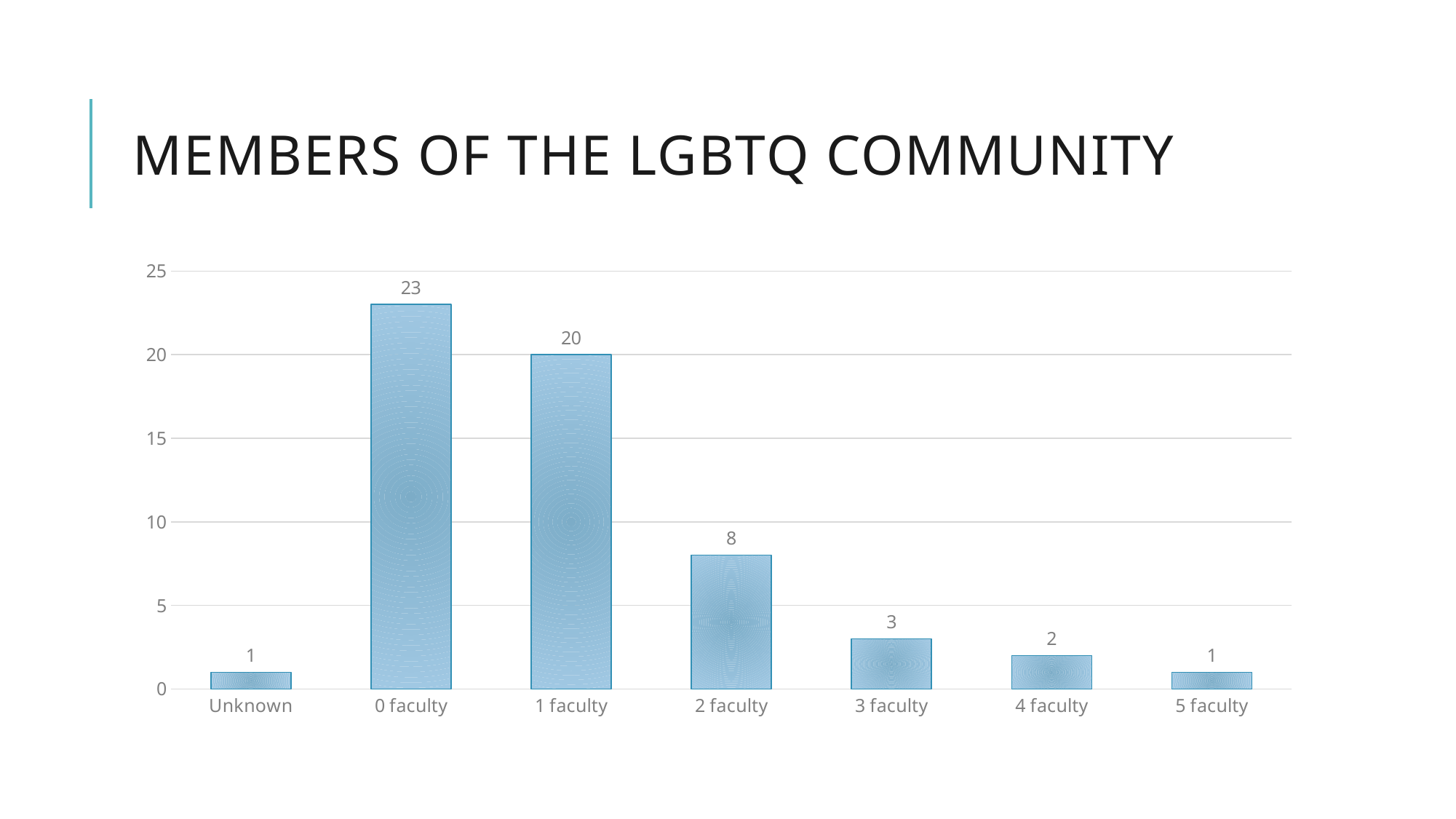
What is the value for Unknown? 1 What kind of chart is shown on the slide? bar chart Do the values rise or fall from 0 faculty to 5 faculty? fall How many categories are shown on the x axis? 7 What is the difference between the values for 0 faculty and 1 faculty? 3 What is the value for 2 faculty? 8 What is the value for 0 faculty? 23 Which is larger, the value for 3 faculty or the value for 4 faculty? 3 faculty Is the value for 1 faculty greater or less than 15? greater What is the title of the slide? MEMBERS OF THE LGBTQ COMMUNITY What is the difference between the values for 2 faculty and 3 faculty? 5 Which category has the highest value? 0 faculty